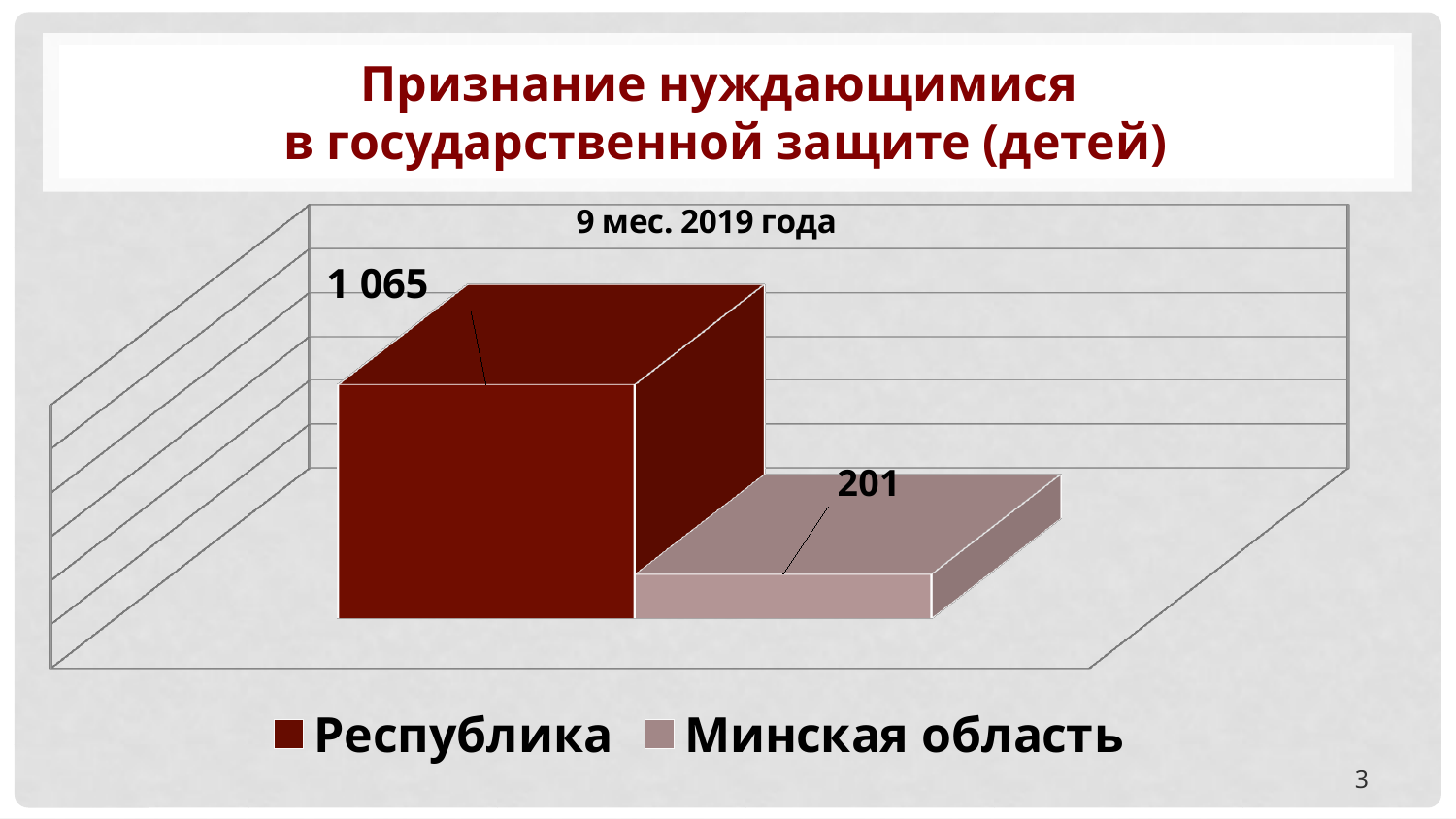
Which series has the highest value? Республика What colour is the bar for Минская область? pinkish grey What is the title of the chart? 9 мес. 2019 года Which is larger, the value for Республика or the value for Минская область? Республика How many series does the legend list? 2 What is the value for Минская область? 201 What is the difference between the values for Республика and Минская область? 864 What kind of chart is shown on the slide? bar chart What is the value for Республика? 1 065 How many bars are plotted in the chart? 2 Which series has the lowest value? Минская область